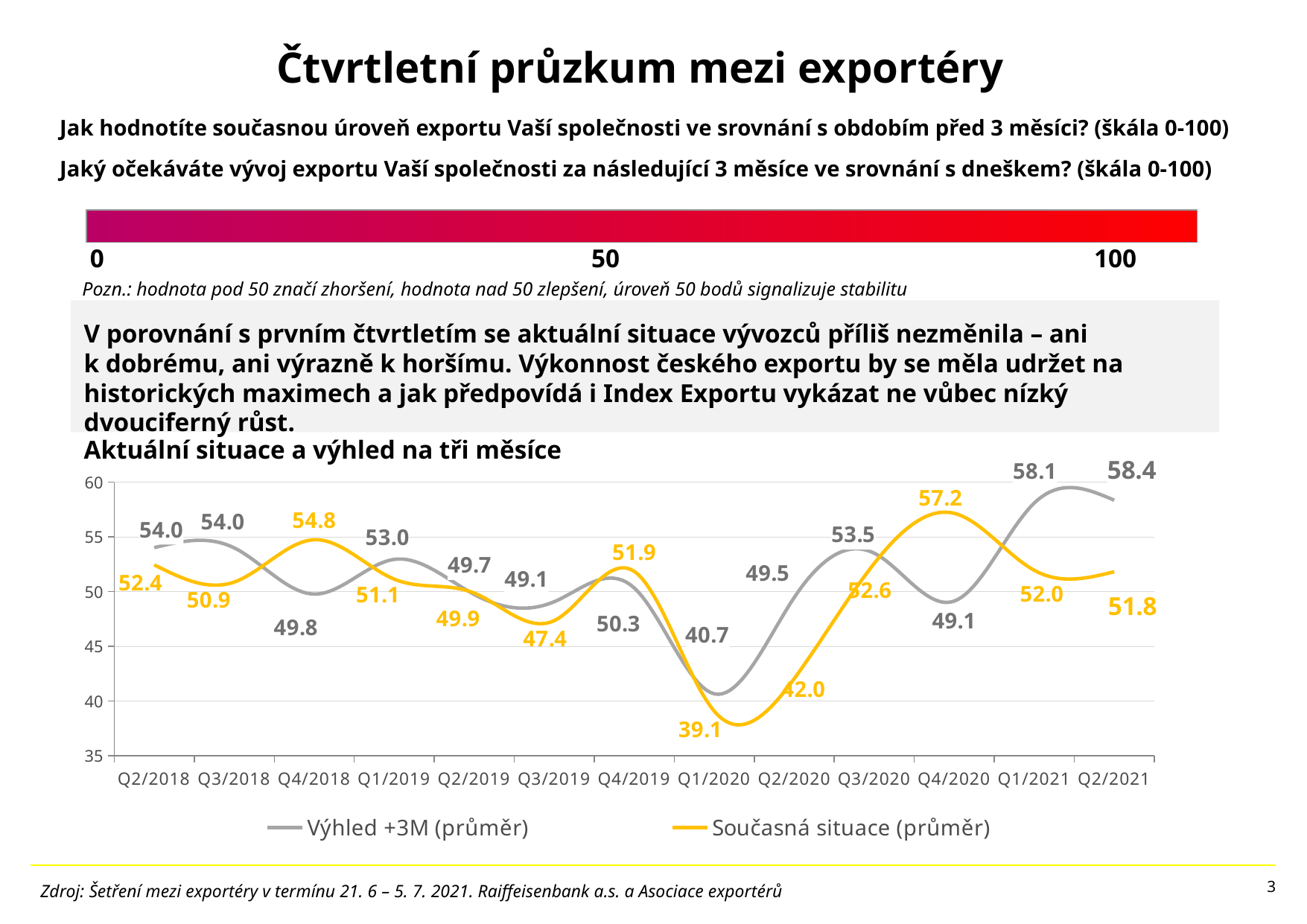
What is the difference between Výhled +3M (průměr) and Současná situace (průměr) in Q2/2021? 6.6 How many quarters are plotted on the x axis of the chart? 13 What is the value of Výhled +3M (průměr) in Q2/2021? 58.4 Does Výhled +3M (průměr) rise or fall from Q4/2020 to Q2/2021? Rise How many series does the chart legend list? 2 In which quarter does Výhled +3M (průměr) reach its lowest value? Q1/2020 In which quarter does Současná situace (průměr) reach its highest value? Q4/2020 In Q4/2018, which series has the higher value: Výhled +3M (průměr) or Současná situace (průměr)? Současná situace (průměr) What is the title of the chart on the slide? Aktuální situace a výhled na tři měsíce What is the value of Výhled +3M (průměr) in Q3/2020? 53.5 What kind of chart is shown on the slide? Line chart What is the value of Současná situace (průměr) in Q1/2020? 39.1